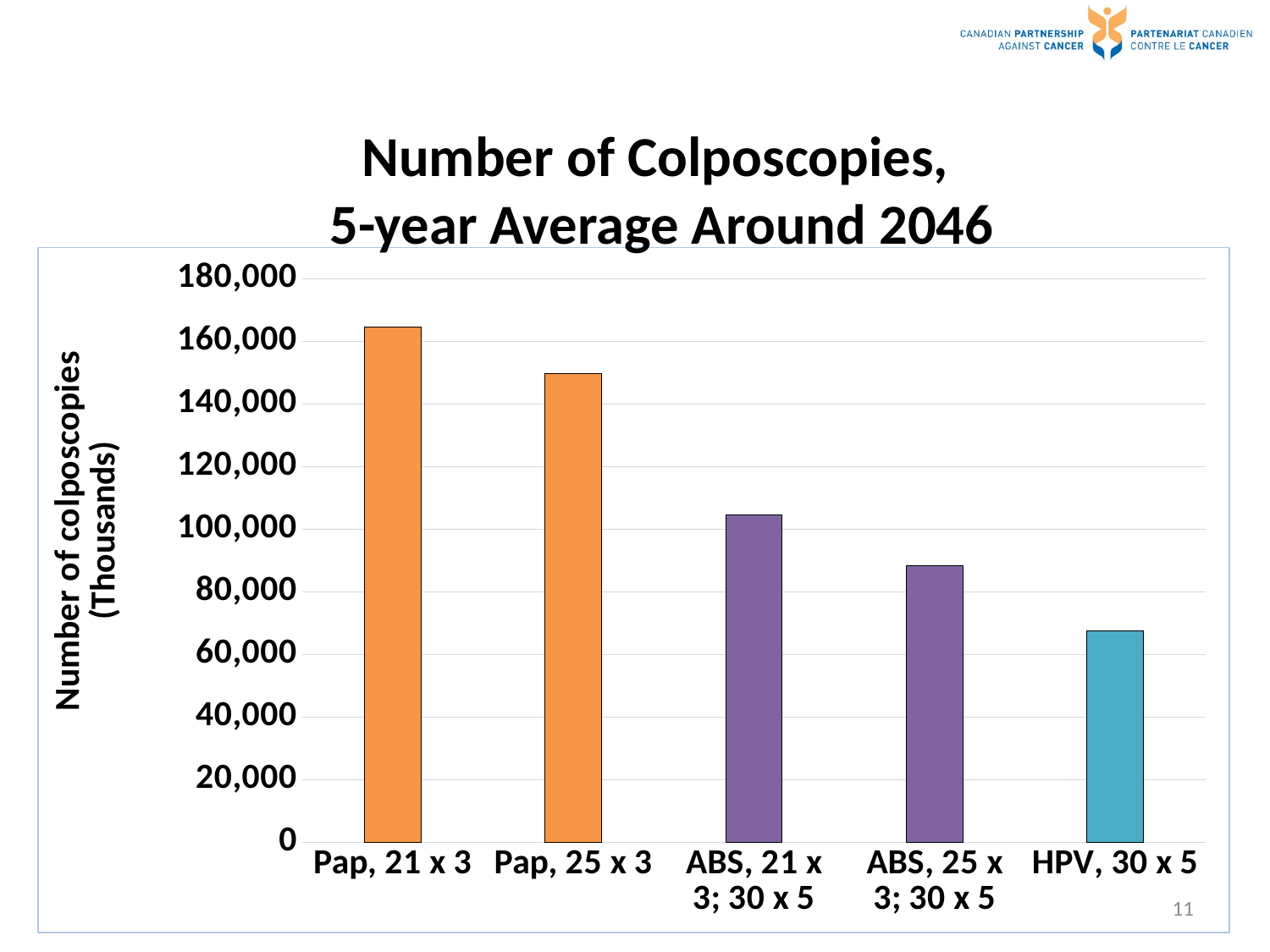
Which category has the highest number of colposcopies? Pap, 21 x 3 What is the label on the vertical axis? Number of colposcopies (Thousands) Which is larger, the value for Pap, 25 x 3 or the value for ABS, 21 x 3; 30 x 5? Pap, 25 x 3 What is the title of the chart? Number of Colposcopies, 5-year Average Around 2046 Do the values rise or fall moving from left to right along the x axis? fall Is the value for Pap, 25 x 3 greater or less than 140,000? greater Is the value for HPV, 30 x 5 greater or less than 80,000? less Which category has the lowest number of colposcopies? HPV, 30 x 5 How many categories (bars) are shown in the chart? 5 Is the value for Pap, 21 x 3 greater or less than 160,000? greater What kind of chart is shown on the slide? bar chart